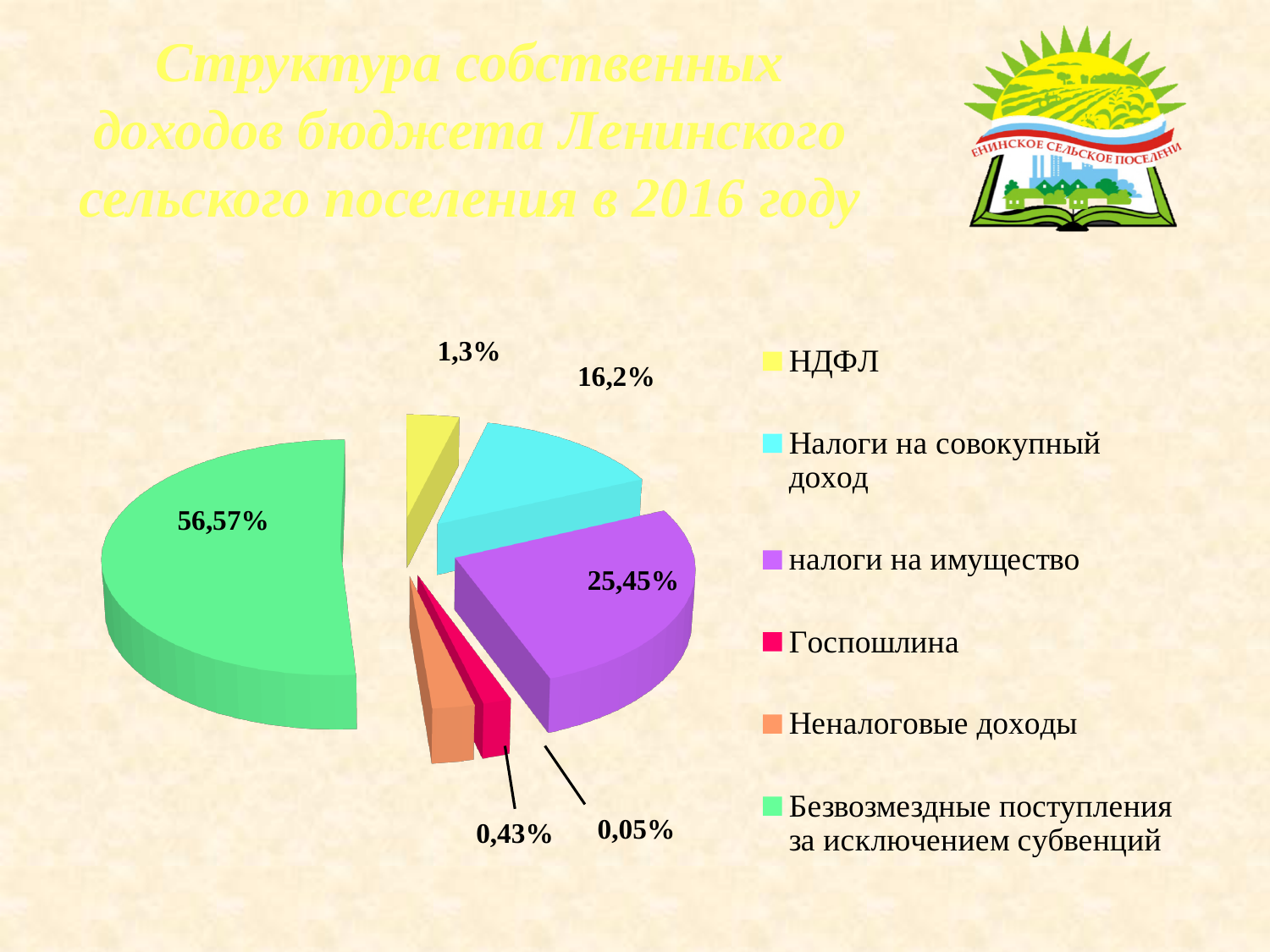
Which is larger, налоги на имущество or Налоги на совокупный доход? налоги на имущество What is the title of the slide containing the chart? Структура собственных доходов бюджета Ленинского сельского поселения в 2016 году What colour is the slice for НДФЛ? yellow What share of the pie does Безвозмездные поступления за исключением субвенций have? 56,57% What is the value shown for Налоги на совокупный доход? 16,2% What is the value shown for НДФЛ? 1,3% What is the difference between the shares of налоги на имущество and Налоги на совокупный доход? 9,25% How many categories does the legend list? 6 What is the difference between the shares of Безвозмездные поступления за исключением субвенций and налоги на имущество? 31,12% Which category has the largest share of the pie? Безвозмездные поступления за исключением субвенций What is the value shown for налоги на имущество? 25,45% What kind of chart is shown on the slide? pie chart